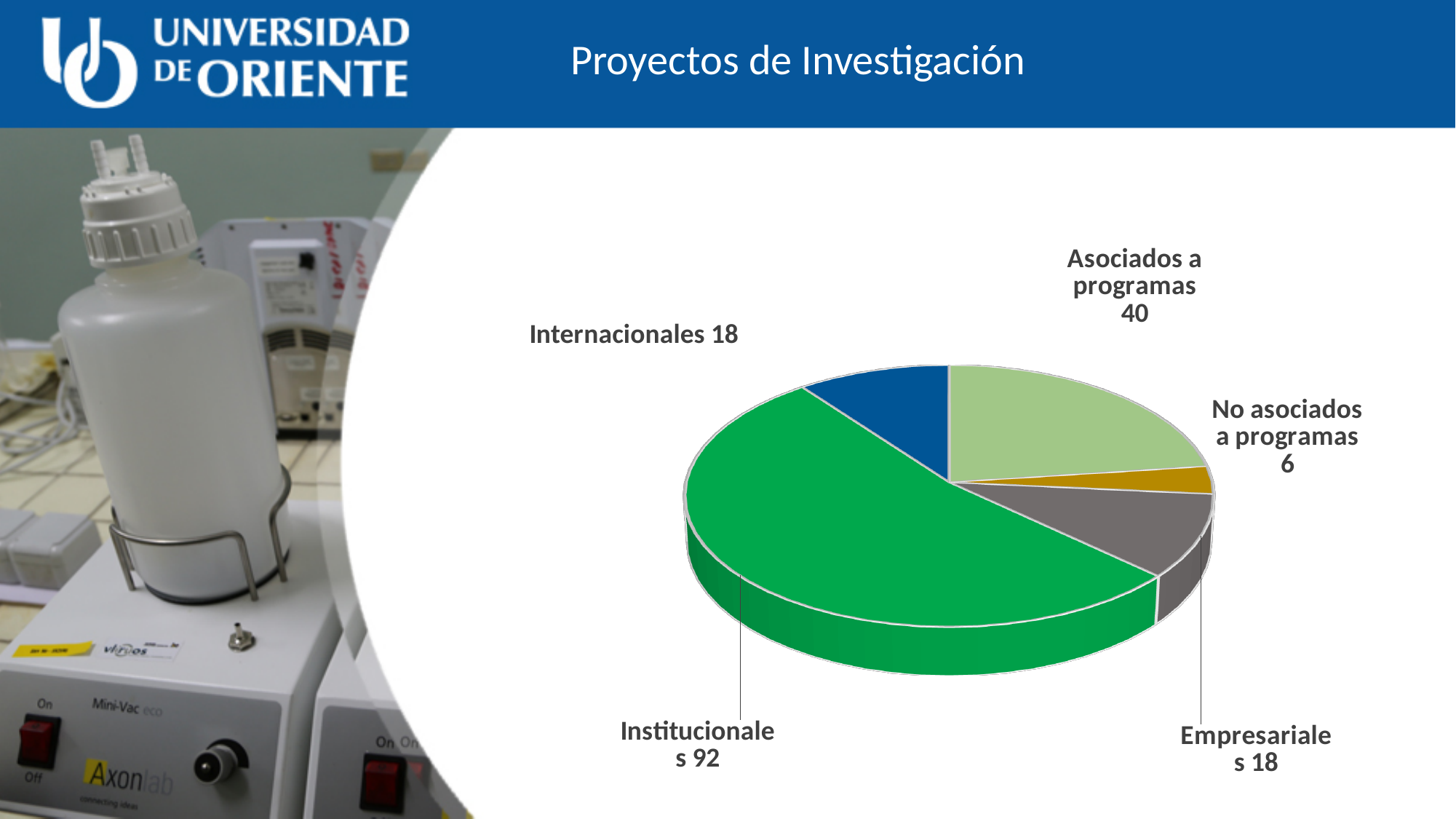
What is the value for Asociados a programas? 40 Which category has the largest slice? Institucionales What is the title of the slide containing the pie chart? Proyectos de Investigación Which is larger, Asociados a programas or Empresariales? Asociados a programas What kind of chart is shown on the slide? pie chart What is the total of all the slices in the pie chart? 174 What is the value for Internacionales? 18 What is the value for Institucionales? 92 What is the value for No asociados a programas? 6 Which category has the smallest slice? No asociados a programas What is the difference between Institucionales and Asociados a programas? 52 How many slices does the pie chart have? 5